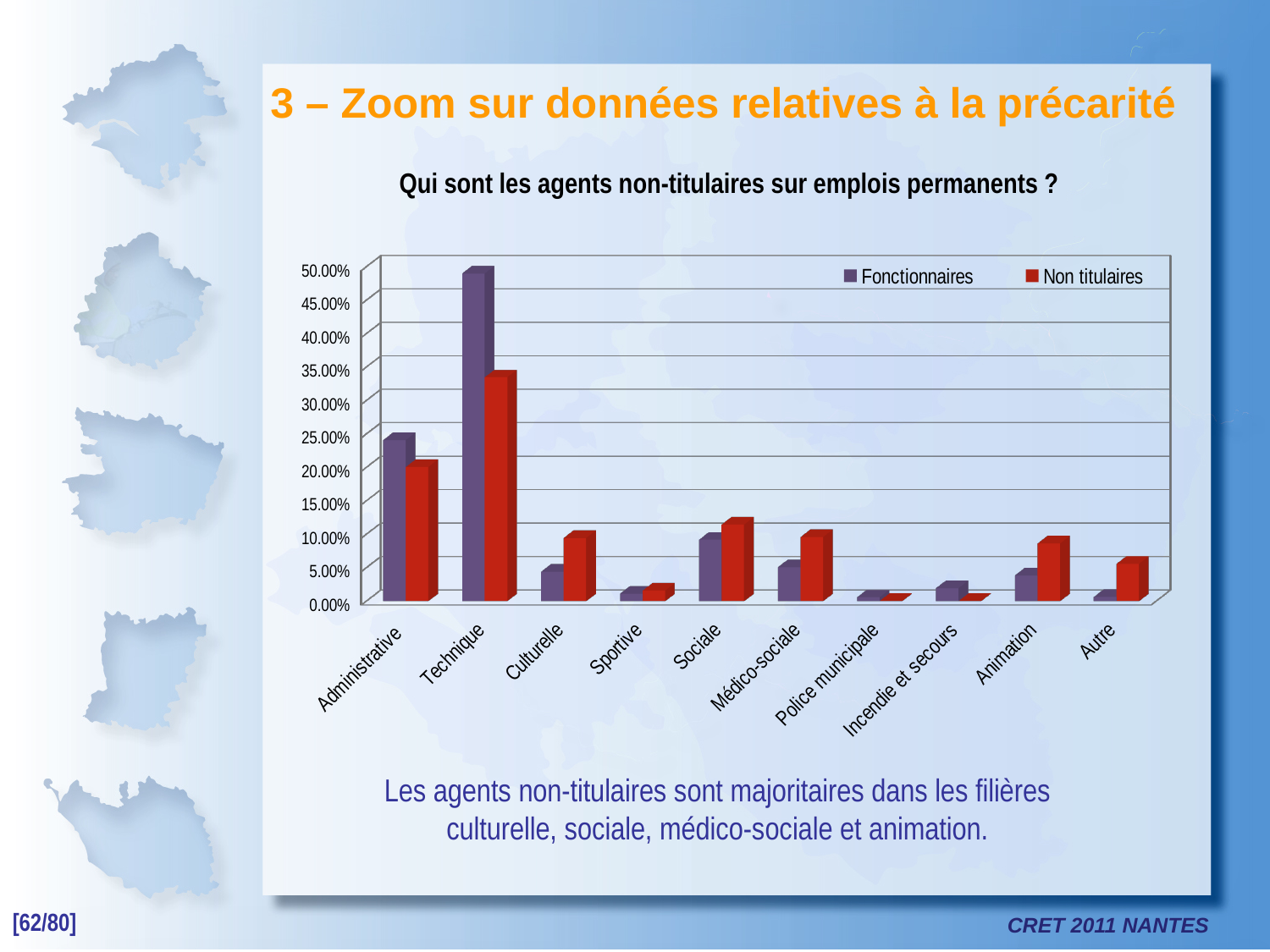
How many categories are shown on the x axis? 10 What kind of chart is shown on the slide? bar chart What are the two entries in the chart legend? Fonctionnaires and Non titulaires Is the Non titulaires value for Autre greater or less than 10.00%? less Is the Non titulaires value for Technique greater or less than 30.00%? greater For Administrative, which series has the larger value, Fonctionnaires or Non titulaires? Fonctionnaires How many series does the legend list? 2 Is the Fonctionnaires value for Administrative greater or less than 20.00%? greater Which category has the highest value for Fonctionnaires? Technique Which category has the highest value for Non titulaires? Technique For Culturelle, which series has the larger value, Fonctionnaires or Non titulaires? Non titulaires